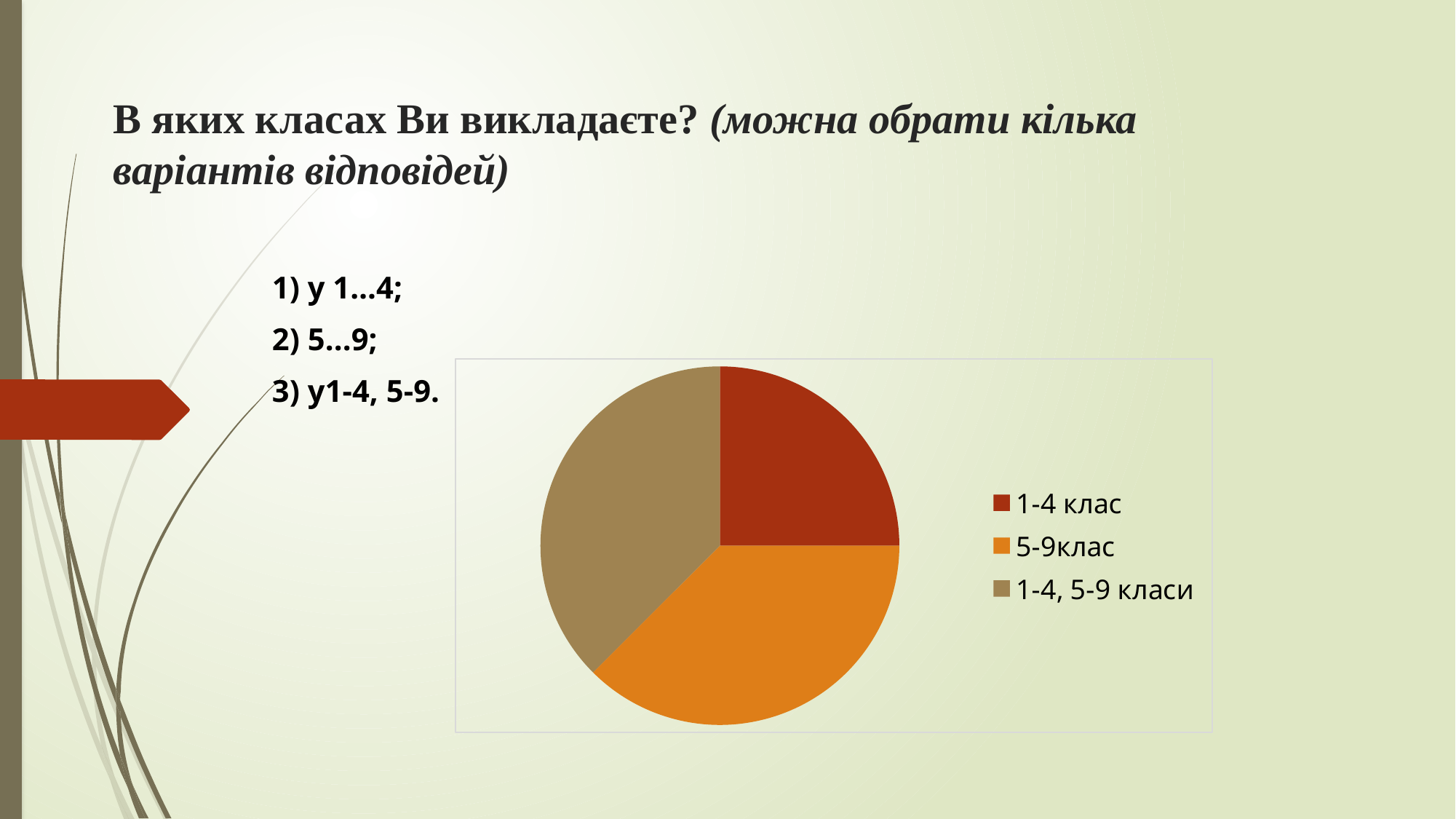
Which legend entry is shown in orange in the pie chart? 5-9клас How many slices does the pie chart have? 3 Which category has the smallest slice in the pie chart? 1-4 клас How many entries does the legend of the pie chart list? 3 Which slice is larger in the pie chart: "1-4 клас" or "1-4, 5-9 класи"? 1-4, 5-9 класи Which legend entry is shown in dark red in the pie chart? 1-4 клас Which slice is larger in the pie chart: "1-4 клас" or "5-9клас"? 5-9клас What kind of chart is shown on the slide? pie chart